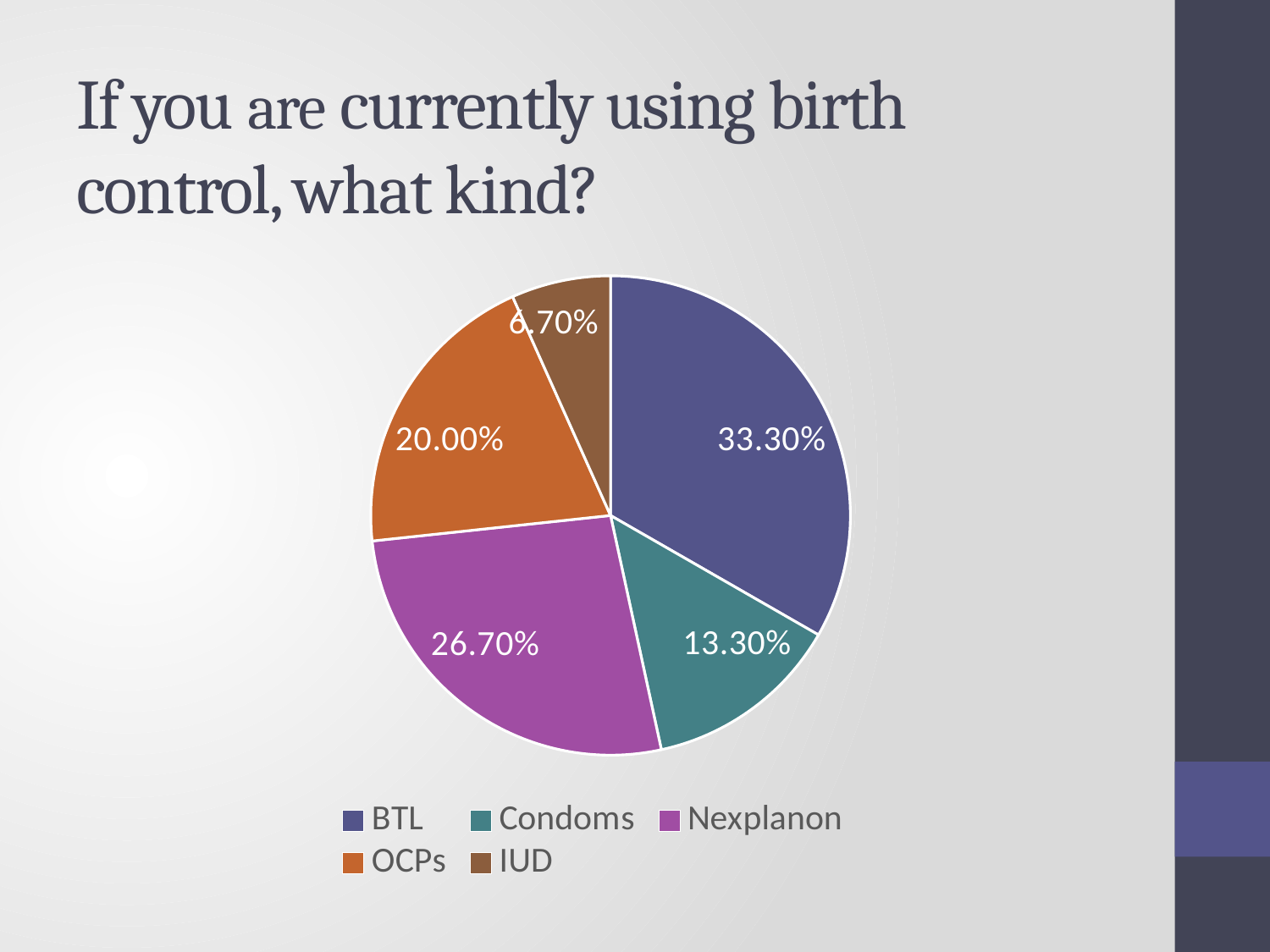
What share of the pie is OCPs? 20.00% How many categories does the pie chart have? 5 What kind of chart is shown on the slide? pie chart What share of the pie is BTL? 33.30% What share of the pie is Nexplanon? 26.70% Which is larger, the OCPs share or the Condoms share? OCPs Which category has the smallest slice of the pie? IUD What share of the pie is IUD? 6.70% Which category has the largest slice of the pie? BTL What is the title of the slide containing the pie chart? If you are currently using birth control, what kind? What share of the pie is Condoms? 13.30% What is the difference between the BTL share and the Nexplanon share? 6.60%